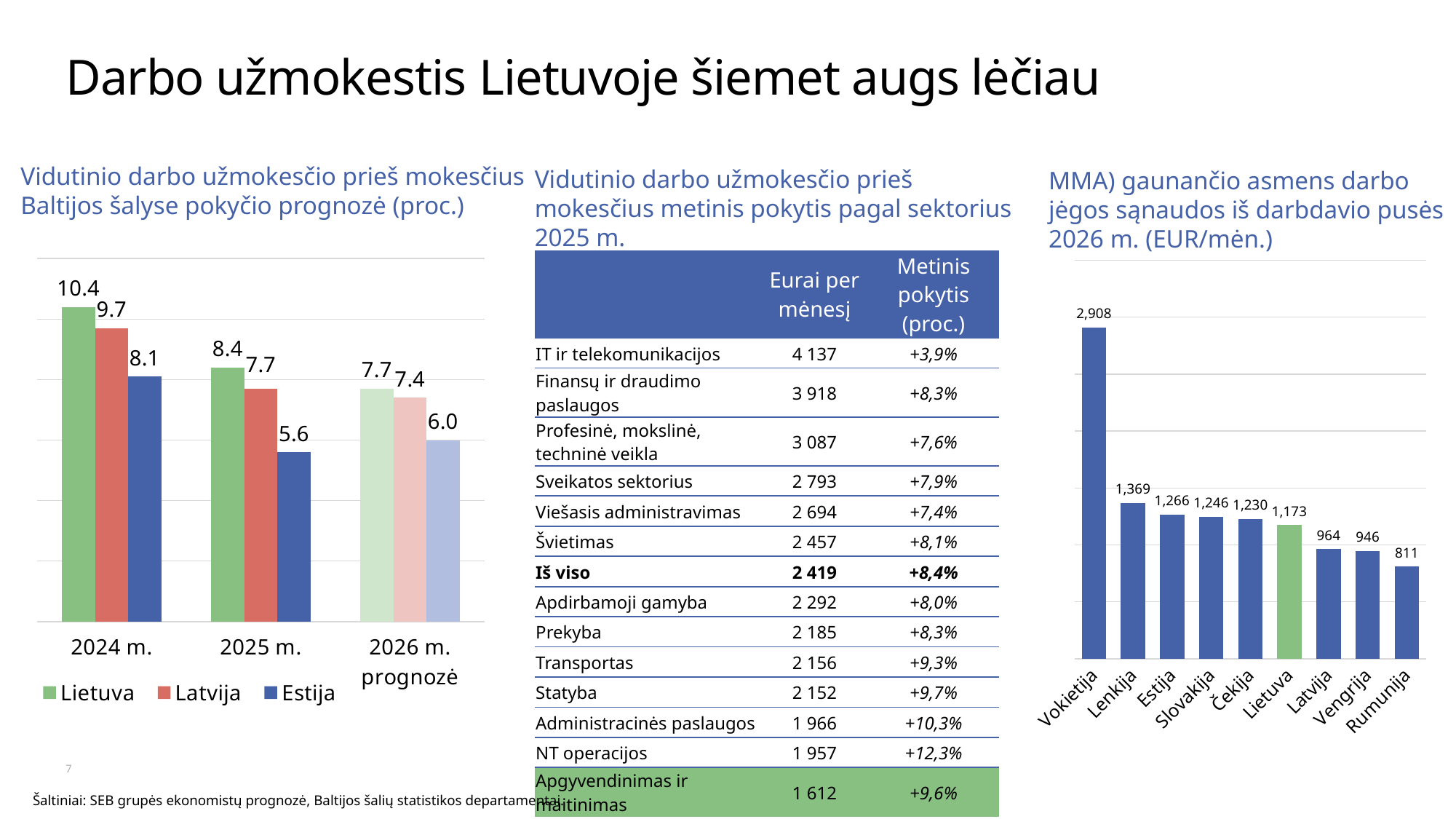
In the right chart (darbo jėgos sąnaudos 2026 m.), what is the value for Lietuva? 1,173 In the left chart (Baltijos šalyse pokyčio prognozė), does the value for Lietuva rise or fall from 2024 m. to 2026 m. prognozė? fall In the left chart (Baltijos šalyse pokyčio prognozė), which country has the lowest value in 2024 m.? Estija In the right chart (darbo jėgos sąnaudos 2026 m.), which country has the lowest value? Rumunija In the right chart (darbo jėgos sąnaudos 2026 m.), how many countries are shown? 9 In the right chart (darbo jėgos sąnaudos 2026 m.), what is the difference between Lenkija and Estija? 103 In the left chart (Baltijos šalyse pokyčio prognozė), what is the value for Lietuva in 2024 m.? 10.4 What kind of chart is the right chart (darbo jėgos sąnaudos 2026 m.)? bar chart In the left chart (Baltijos šalyse pokyčio prognozė), what is the difference between Lietuva and Latvija in 2026 m. prognozė? 0.3 In the left chart (Baltijos šalyse pokyčio prognozė), what is the value for Estija in 2025 m.? 5.6 In the left chart (Baltijos šalyse pokyčio prognozė), how many series does the legend list? 3 In the right chart (darbo jėgos sąnaudos 2026 m.), what is the value for Vokietija? 2,908